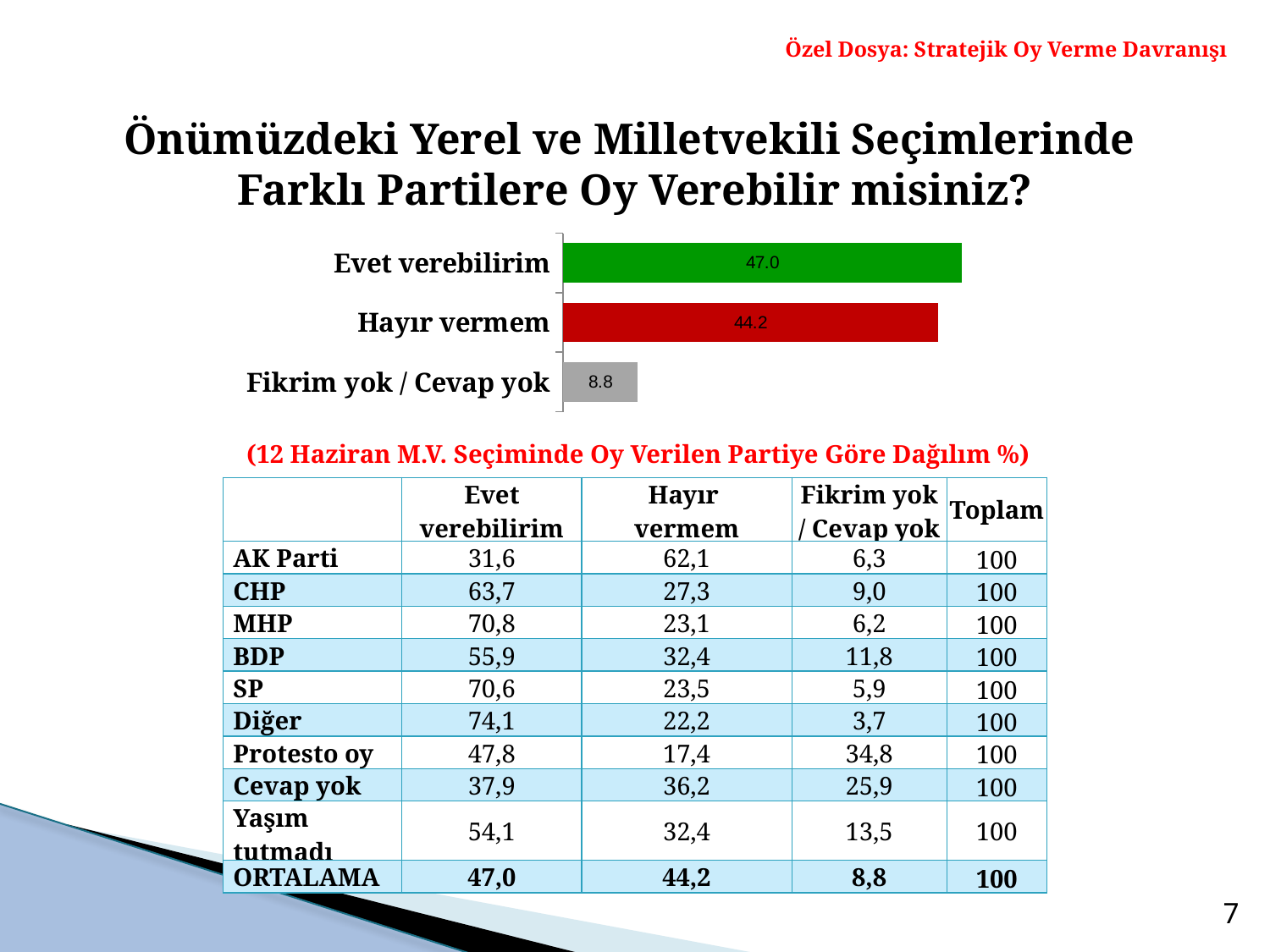
What colour is the bar for "Evet verebilirim" in the chart? Green Which category has the lowest value in the bar chart? Fikrim yok / Cevap yok What kind of chart is shown on the slide? Bar chart What value does the bar chart show for "Evet verebilirim"? 47.0 What value does the bar chart show for "Hayır vermem"? 44.2 What value does the bar chart show for "Fikrim yok / Cevap yok"? 8.8 In the bar chart, which is larger: the value for "Hayır vermem" or the value for "Fikrim yok / Cevap yok"? Hayır vermem What is the difference between the values for "Hayır vermem" and "Fikrim yok / Cevap yok" in the bar chart? 35.4 How many categories are shown in the bar chart? 3 Which category has the highest value in the bar chart? Evet verebilirim What is the difference between the values for "Evet verebilirim" and "Hayır vermem" in the bar chart? 2.8 What colour is the bar for "Hayır vermem" in the chart? Red